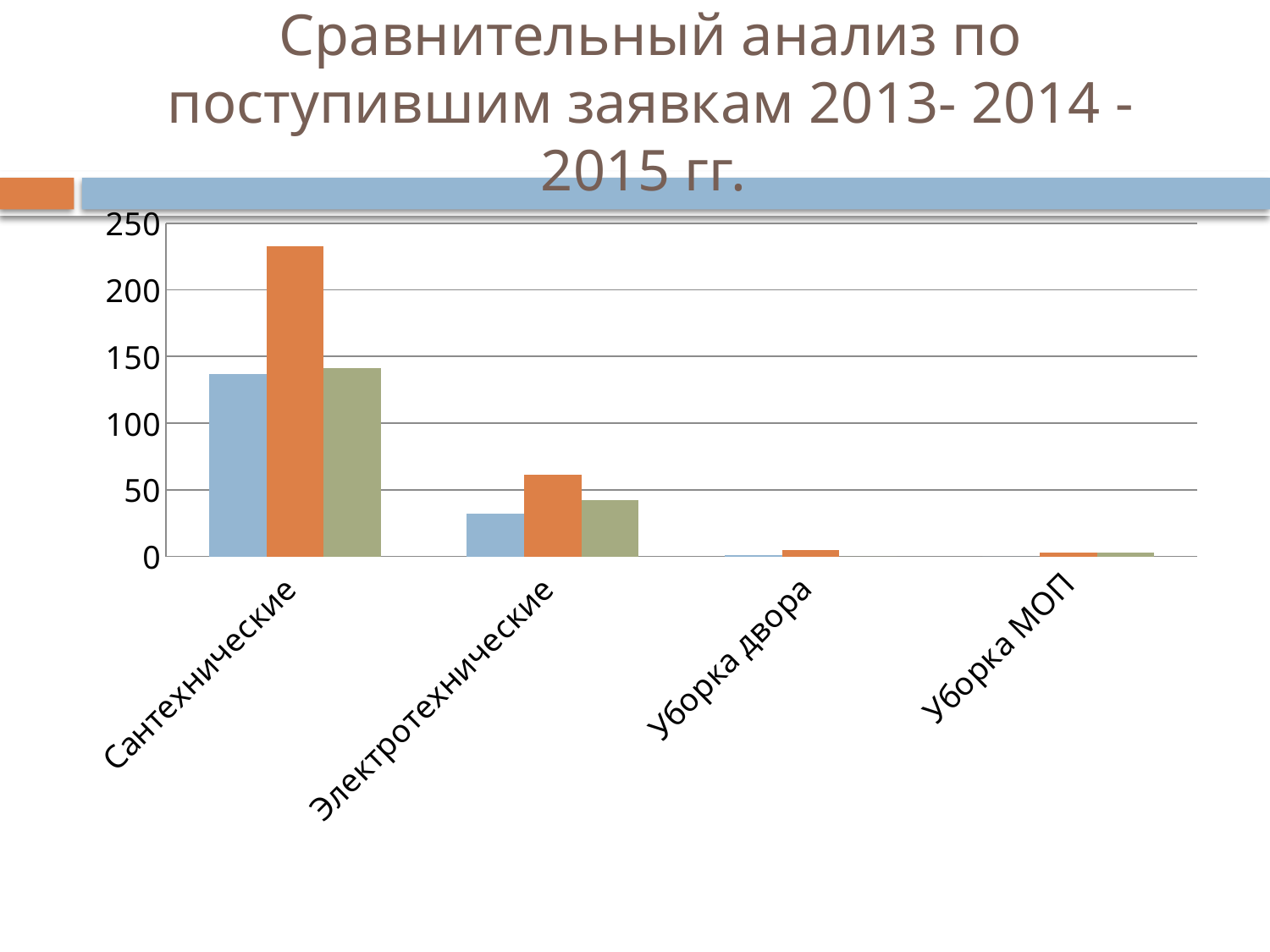
Is the green bar for Сантехнические greater or less than 100? greater Is the blue bar for Сантехнические greater or less than 150? less Is the orange bar for Электротехнические greater or less than 50? greater Which is larger for Сантехнические: the orange bar or the blue bar? the orange bar Which category has the tallest bar in the chart? Сантехнические What is the highest value shown on the y axis of the chart? 250 What is the title of the chart on the slide? Сравнительный анализ по поступившим заявкам 2013- 2014 - 2015 гг. Which category has the larger orange bar: Электротехнические or уборка двора? Электротехнические What kind of chart is shown on the slide? bar chart How many categories are shown on the x axis of the chart? 4